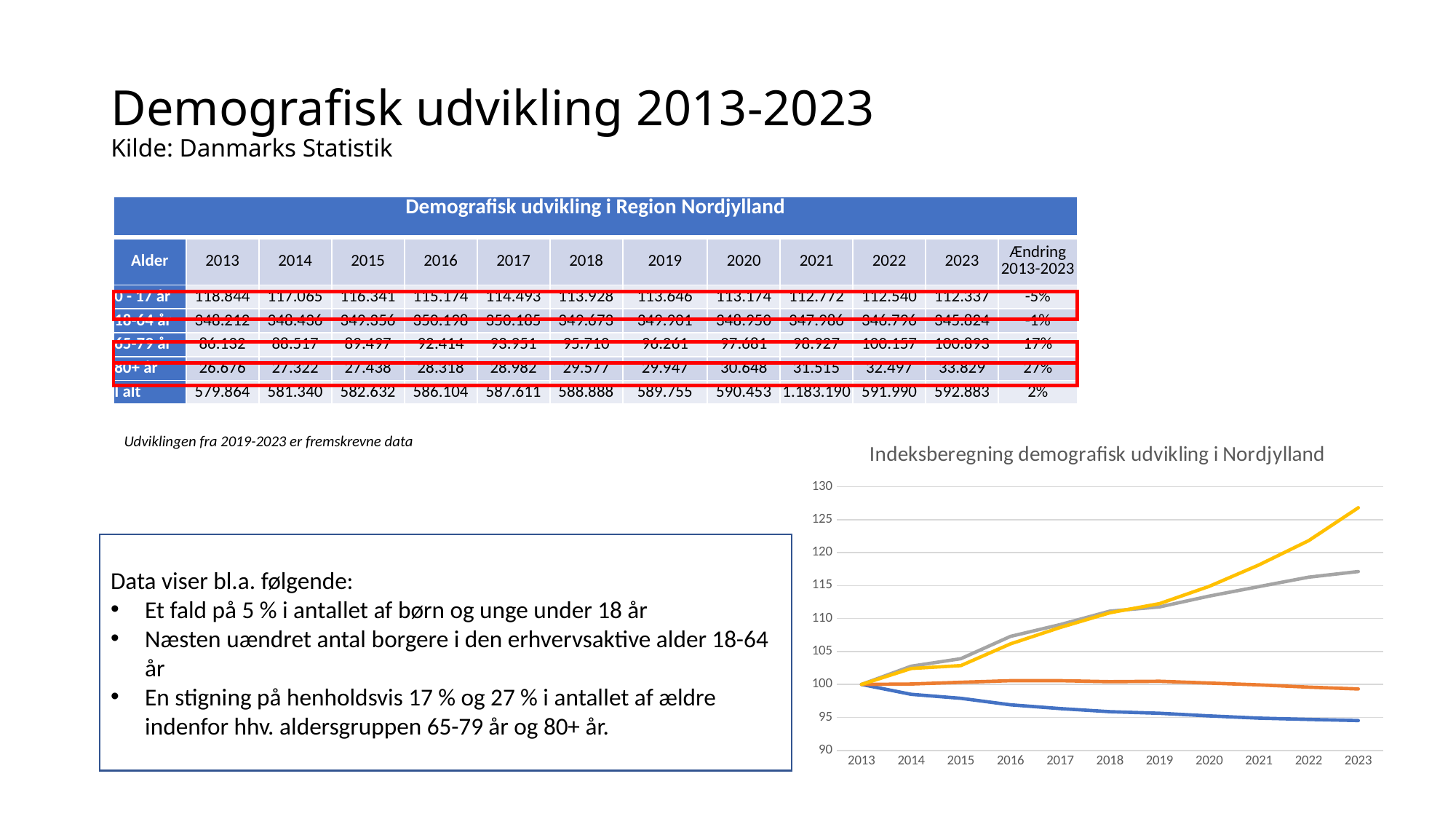
In the 'Indeksberegning demografisk udvikling i Nordjylland' chart, does the blue line rise or fall from 2013 to 2023? fall In the 'Indeksberegning demografisk udvikling i Nordjylland' chart, is the value of the blue line in 2023 greater or less than 100? less In the 'Indeksberegning demografisk udvikling i Nordjylland' chart, which is larger in 2020: the yellow line or the orange line? the yellow line In the 'Indeksberegning demografisk udvikling i Nordjylland' chart, which line is highest in 2023? the yellow line In the 'Indeksberegning demografisk udvikling i Nordjylland' chart, which line is lowest in 2023? the blue line How many years are shown on the x axis of the 'Indeksberegning demografisk udvikling i Nordjylland' chart? 11 In the 'Indeksberegning demografisk udvikling i Nordjylland' chart, is the value of the yellow line in 2023 greater or less than 125? greater What kind of chart is 'Indeksberegning demografisk udvikling i Nordjylland'? line chart In the 'Indeksberegning demografisk udvikling i Nordjylland' chart, what index value do all lines share in 2013? 100 In the 'Indeksberegning demografisk udvikling i Nordjylland' chart, does the yellow line rise or fall from 2013 to 2023? rise How many lines are plotted in the 'Indeksberegning demografisk udvikling i Nordjylland' chart? 4 In the 'Indeksberegning demografisk udvikling i Nordjylland' chart, is the value of the grey line in 2023 greater or less than 115? greater